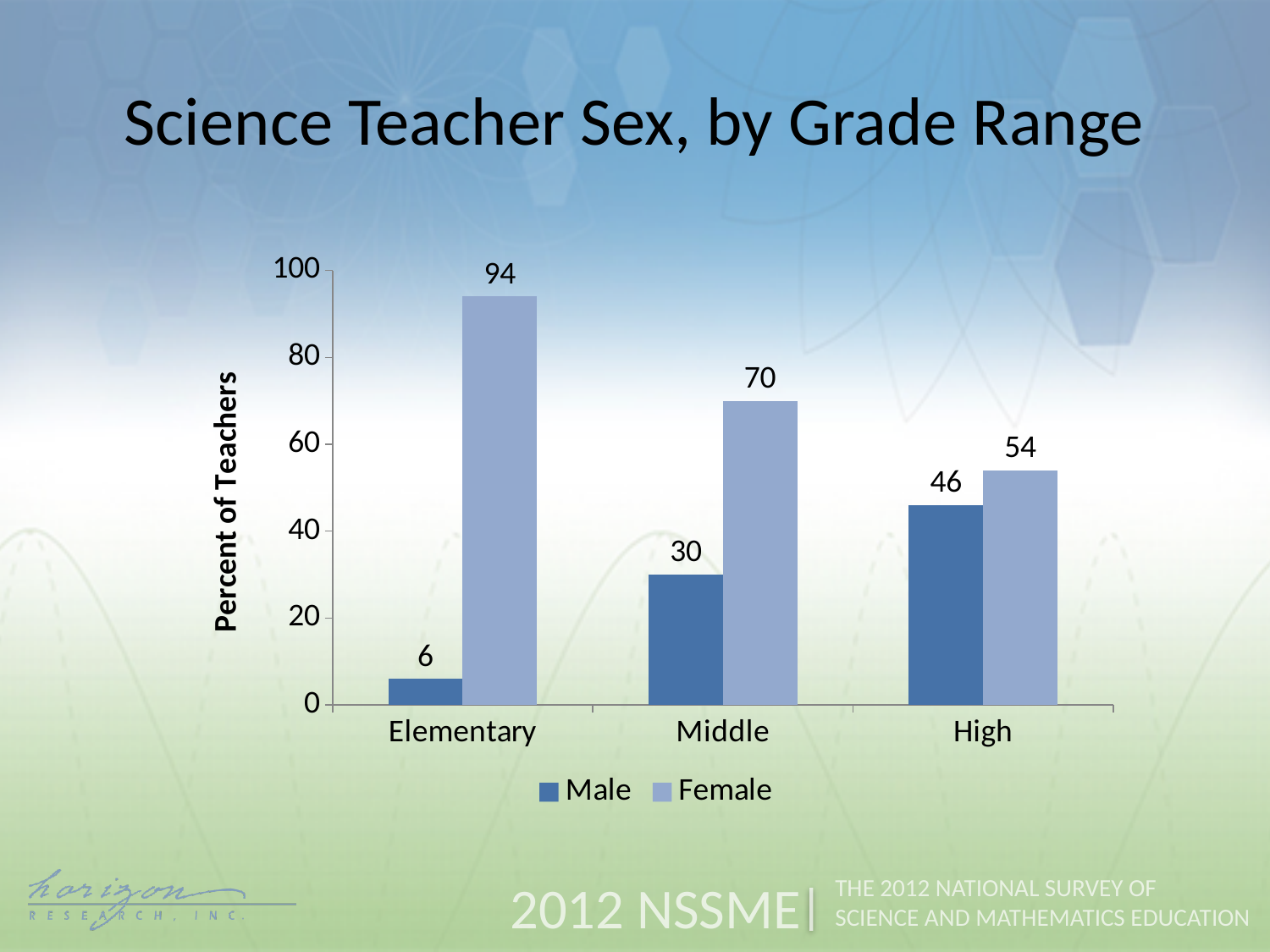
What percent of middle school science teachers are male? 30 Is the Male value for High greater or less than 40? greater How many series does the legend list? 2 Which grade range has the highest percentage of male science teachers? High What percent of elementary science teachers are female? 94 Which grade range has the lowest percentage of female science teachers? High Do the Male values rise or fall from Elementary to High? Rise What is the difference between the Female and Male values for the Elementary grade range? 88 How many grade ranges are shown on the x axis? 3 What kind of chart is shown on the slide? Bar chart What is the value for Female in the High grade range? 54 Which is larger for the Middle grade range, the Male value or the Female value? Female